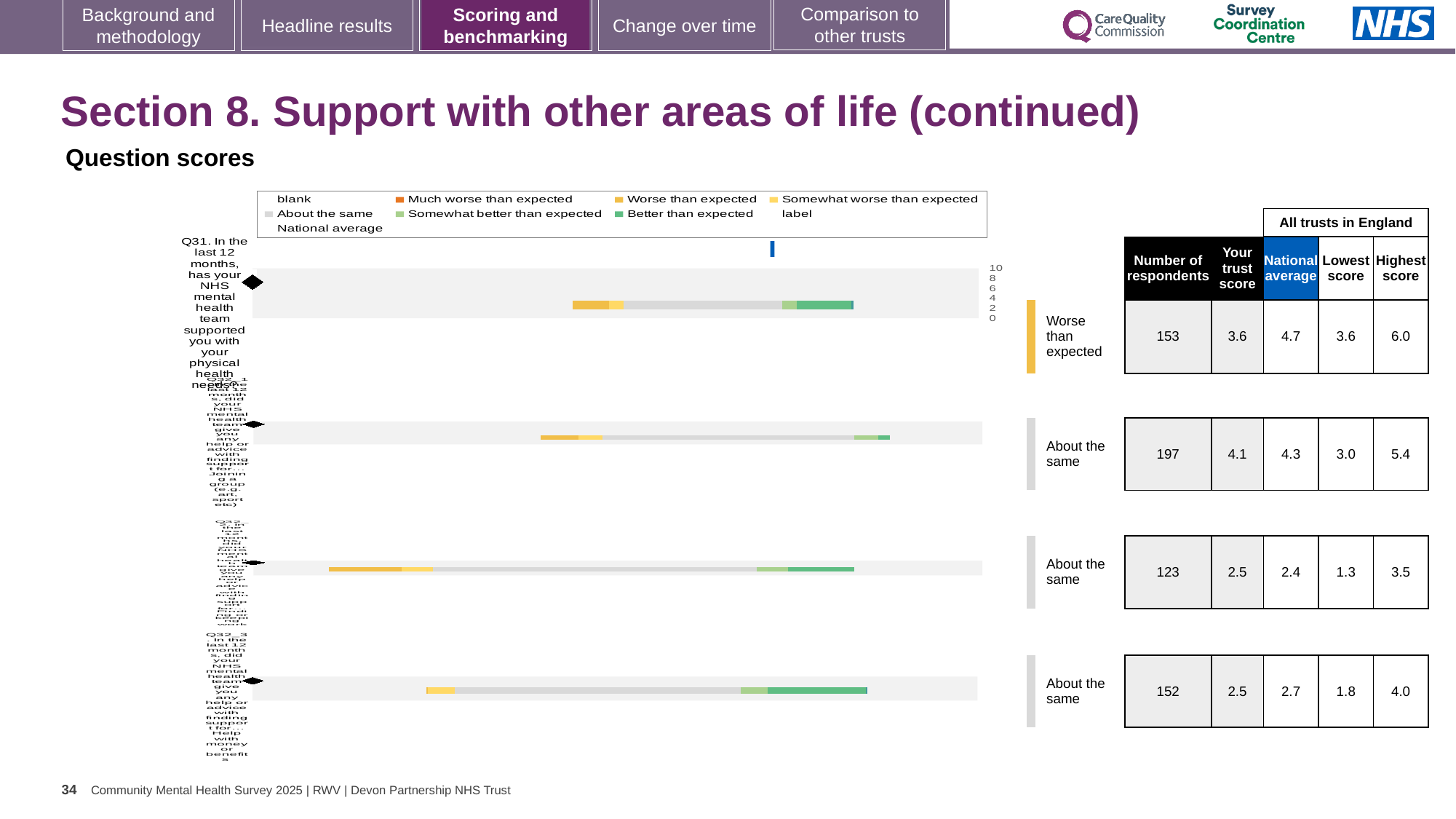
What is the highest score listed for the bottom row (Q32_3) in the table beside the chart? 4.0 What is the trust score for Q31 in the table beside the chart? 3.6 What kind of chart is shown on the slide? bar chart What is the national average for Q31 in the table beside the chart? 4.7 For Q31, which is larger: the trust score or the national average? national average What is the benchmark category shown for the top bar (Q31) in the chart? Worse than expected How many question bars are plotted in the chart? 4 How many entries does the chart legend list? 9 How many respondents are listed for Q31 in the table beside the chart? 153 What is the difference between the highest score and the lowest score for Q31 in the table? 2.4 Which row of the table beside the chart has the most respondents? the second row (197) What colour represents 'Better than expected' in the chart legend? green